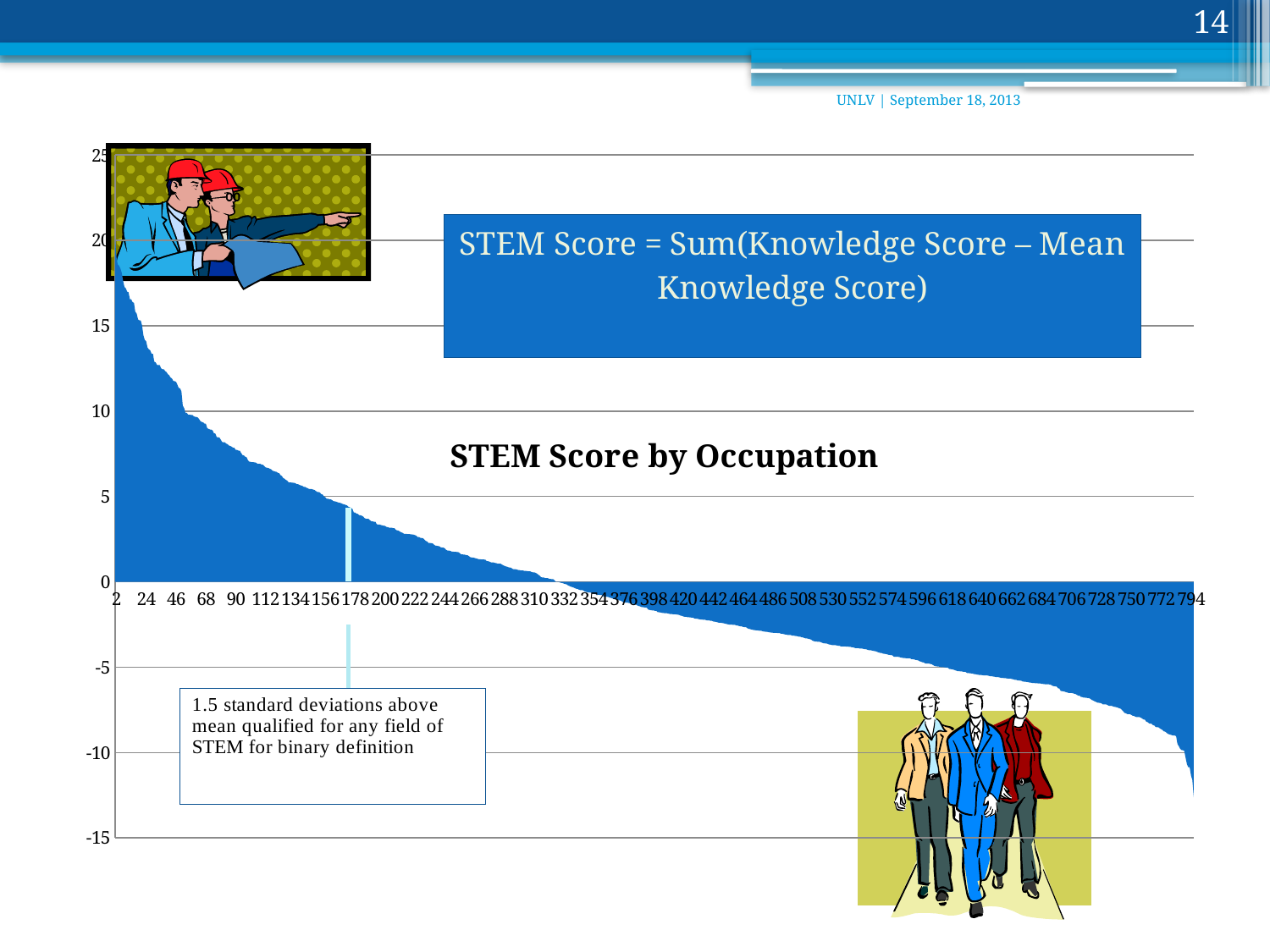
According to the formula shown on the slide, how is the STEM Score calculated? Sum(Knowledge Score – Mean Knowledge Score) Is the STEM score for occupation 112 greater or less than 5? greater What is the title of the chart? STEM Score by Occupation Which has the larger STEM score, occupation 24 or occupation 750? 24 Is the STEM score for occupation 530 greater or less than 0? less Do the STEM score values rise or fall as you move from left to right along the x axis? fall Is the STEM score for occupation 200 greater or less than 5? less Which has the larger STEM score, occupation 640 or occupation 266? 266